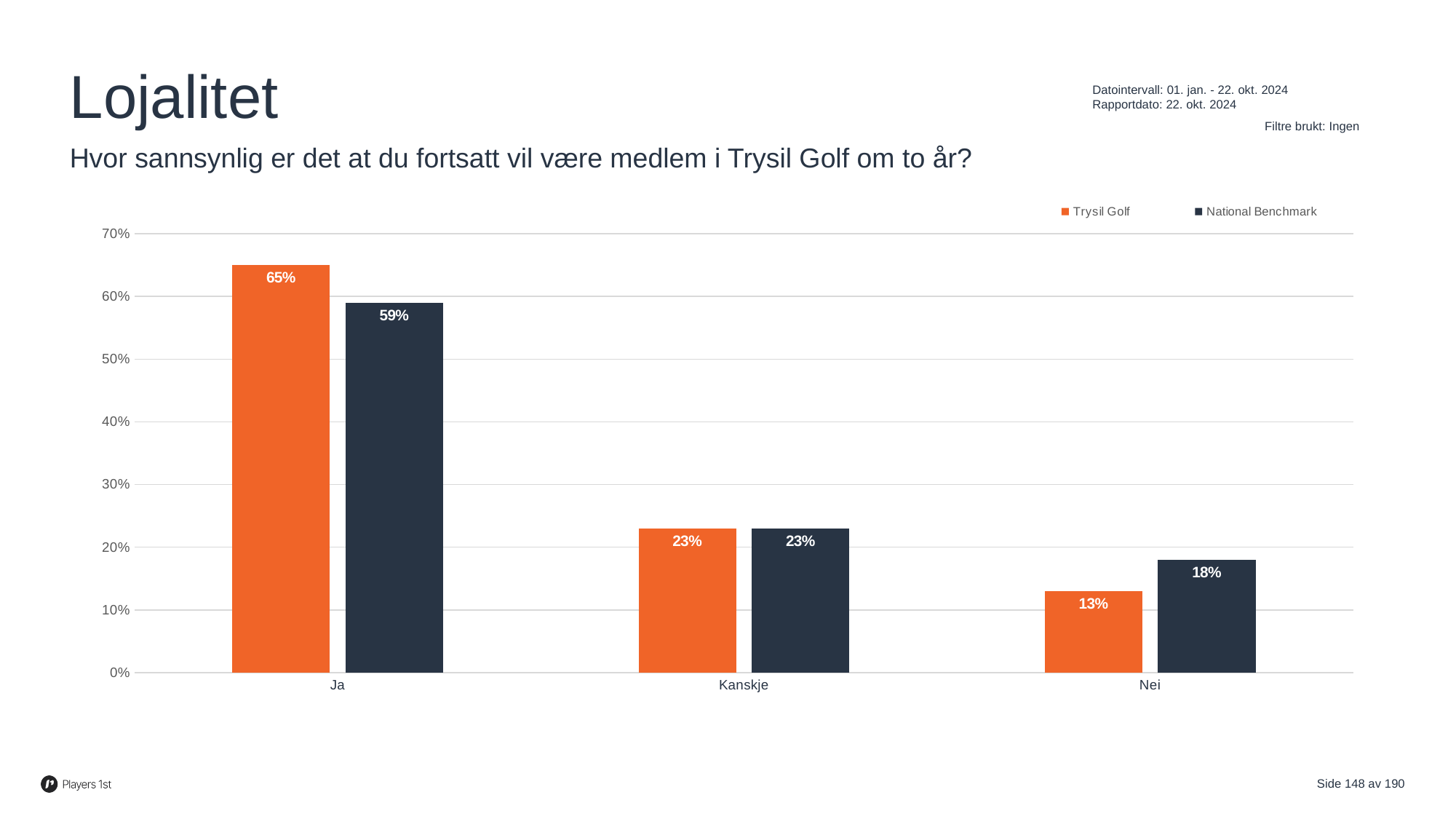
What is the difference between Trysil Golf and National Benchmark in the Ja category? 6% What is the value for National Benchmark in the Nei category? 18% Which is larger in the Nei category, Trysil Golf or National Benchmark? National Benchmark How many series does the legend list? 2 Which series is shown in orange in the legend? Trysil Golf What is the value for National Benchmark in the Ja category? 59% Which category has the lowest value for National Benchmark? Nei What kind of chart is shown on the slide? Bar chart Which category has the highest value for Trysil Golf? Ja What is the value for Trysil Golf in the Ja category? 65% How many categories are shown on the x axis? 3 What is the value for Trysil Golf in the Nei category? 13%